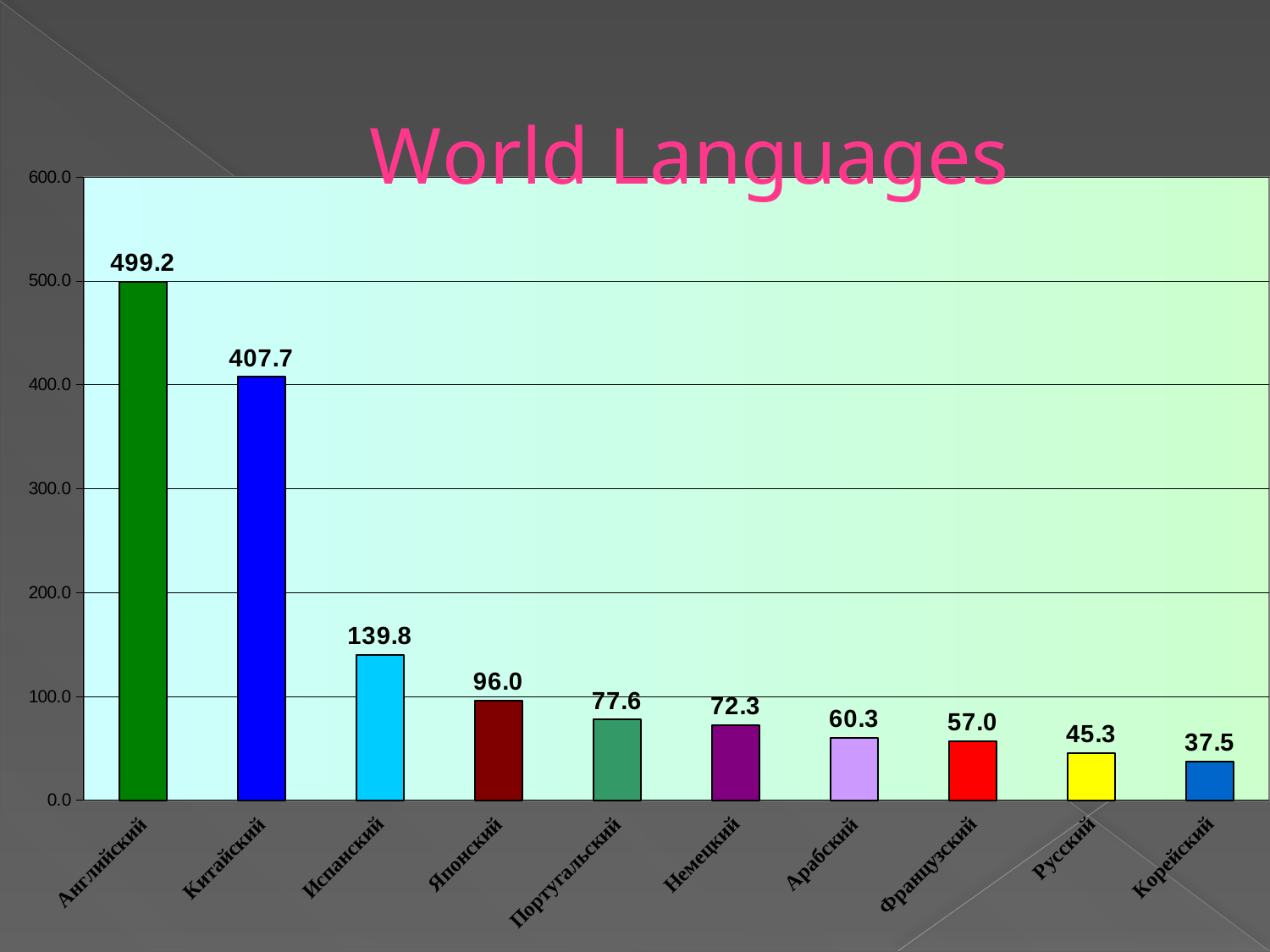
What is the difference between the values for Английский and Китайский? 91.5 What is the difference between the values for Японский and Португальский? 18.4 Which is larger, the value for Немецкий or the value for Французский? Немецкий Is the value for Китайский greater or less than 400.0? greater What kind of chart is shown on the slide? bar chart Which category has the lowest value? Корейский Which category has the highest value? Английский What is the value for Английский? 499.2 What is the value for Испанский? 139.8 What is the title of the chart? World Languages What is the value for Арабский? 60.3 How many categories are shown on the x axis? 10